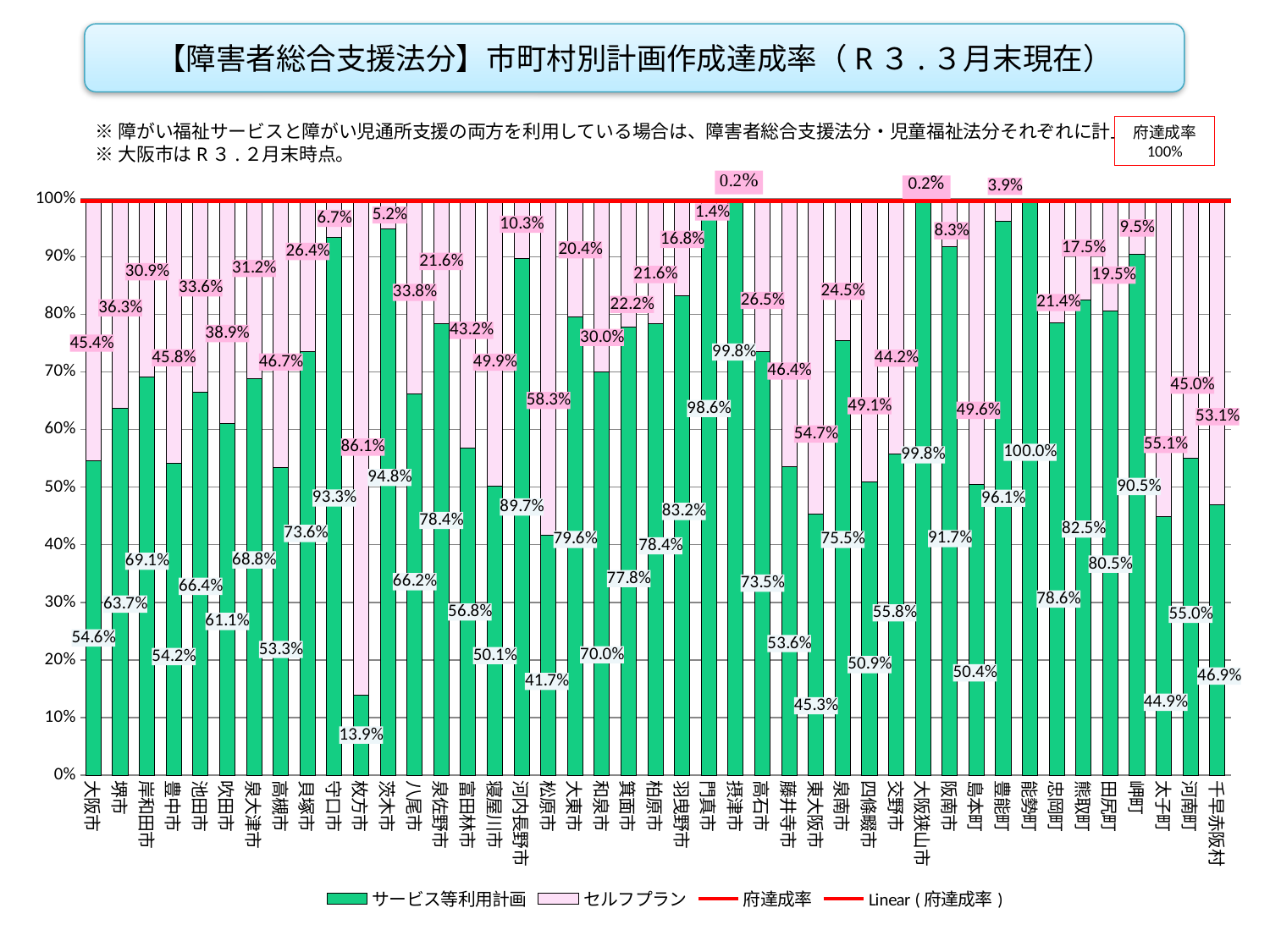
How many entries does the legend list? 4 Which municipality has the highest サービス等利用計画 value? 能勢町 How many municipalities are shown on the x axis? 43 What is the サービス等利用計画 value for 能勢町? 100.0% What kind of chart is shown on the slide? Stacked bar chart combined with a line (府達成率 line at 100%) Is the サービス等利用計画 value for 東大阪市 greater or less than 50%? less Which has the larger サービス等利用計画 value, 守口市 or 茨木市? 茨木市 What is the difference between the サービス等利用計画 values for 堺市 and 大阪市? 9.1 percentage points Which municipality has the lowest サービス等利用計画 value? 枚方市 What is the セルフプラン value for 大阪市? 45.4% Which municipality has the highest セルフプラン value? 枚方市 What is the サービス等利用計画 value for 枚方市? 13.9%